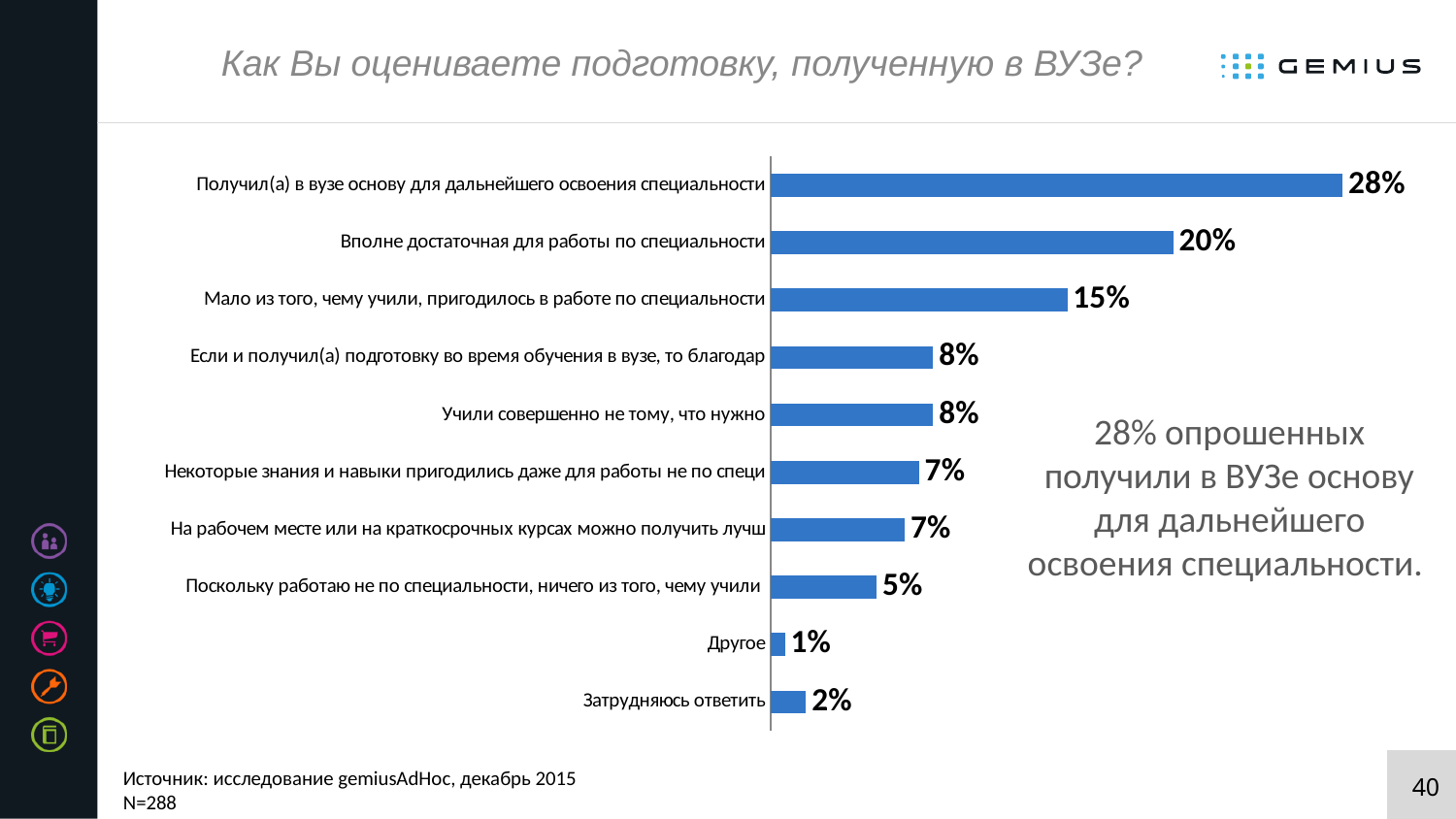
Which is larger: the value for "Мало из того, чему учили, пригодилось в работе по специальности" or the value for "Учили совершенно не тому, что нужно"? Мало из того, чему учили, пригодилось в работе по специальности How many categories are shown in the chart? 10 Which category has the lowest value? Другое What is the value for "Учили совершенно не тому, что нужно"? 8% What is the value for "Затрудняюсь ответить"? 2% What is the value for "Вполне достаточная для работы по специальности"? 20% What is the difference between the values for "Мало из того, чему учили, пригодилось в работе по специальности" and "Затрудняюсь ответить"? 13% What is the value for "Поскольку работаю не по специальности, ничего из того, чему учили"? 5% What kind of chart is shown on the slide? Bar chart What is the title of the slide? Как Вы оцениваете подготовку, полученную в ВУЗе? Which category has the highest value? Получил(а) в вузе основу для дальнейшего освоения специальности What is the difference between the values for "Получил(а) в вузе основу для дальнейшего освоения специальности" and "Вполне достаточная для работы по специальности"? 8%